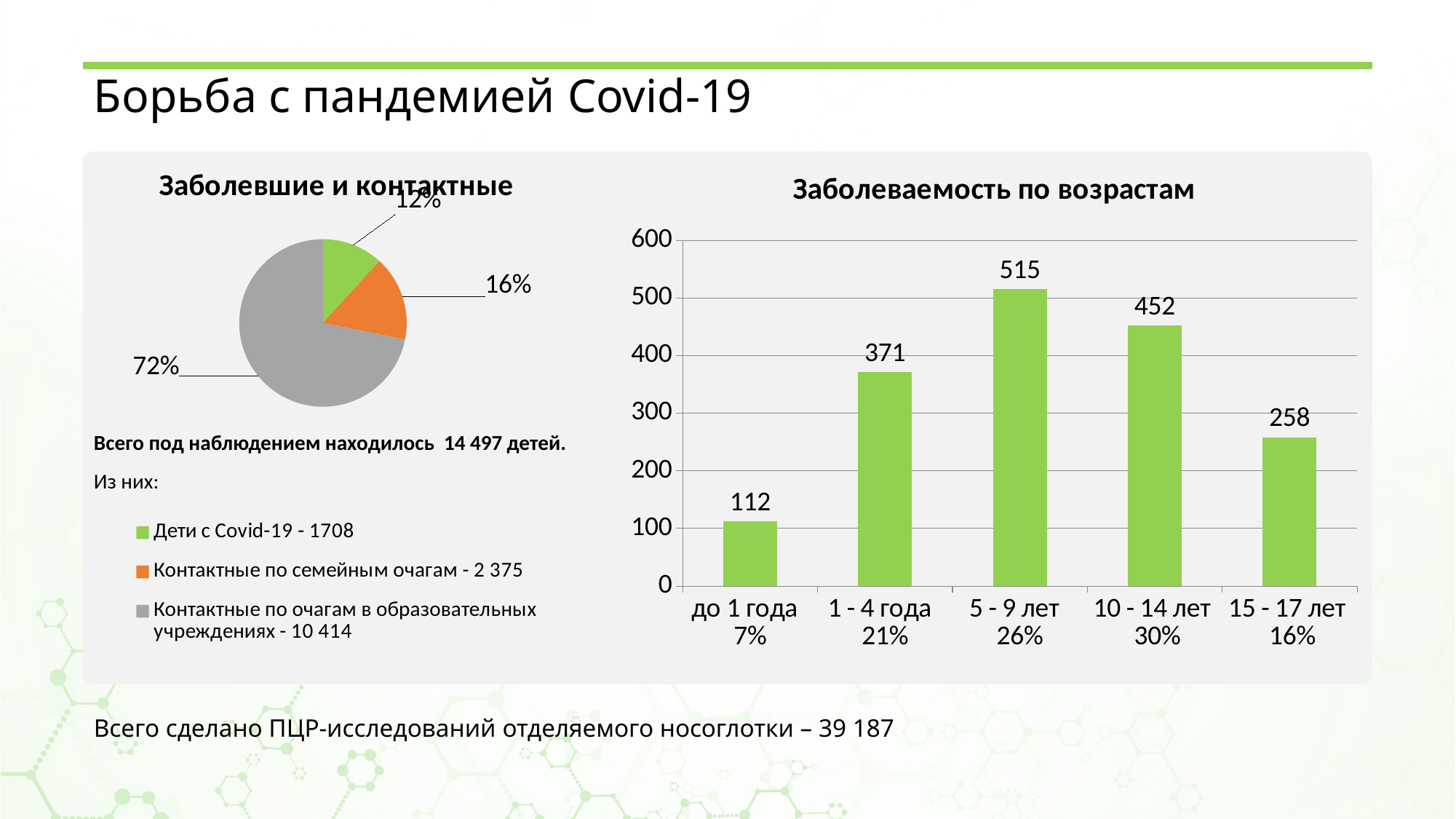
In the chart 'Заболеваемость по возрастам', what is the difference between the values for '10 - 14 лет' and '15 - 17 лет'? 194 What kind of chart is 'Заболевшие и контактные'? pie chart In the chart 'Заболеваемость по возрастам', what is the value for the '5 - 9 лет' age group? 515 How many age groups are shown in the chart 'Заболеваемость по возрастам'? 5 In the chart 'Заболеваемость по возрастам', what is the value for the 'до 1 года' age group? 112 In the pie chart 'Заболевшие и контактные', what colour is the slice for 'Контактные по семейным очагам'? orange What kind of chart is 'Заболеваемость по возрастам'? bar chart In the chart 'Заболеваемость по возрастам', which age group has the highest value? 5 - 9 лет In the pie chart 'Заболевшие и контактные', what share does the grey slice (Контактные по очагам в образовательных учреждениях) have? 72% In the chart 'Заболеваемость по возрастам', which age group has the lowest value? до 1 года In the chart 'Заболеваемость по возрастам', which is larger: the value for '1 - 4 года' or the value for '15 - 17 лет'? 1 - 4 года In the pie chart 'Заболевшие и контактные', what share does the slice for 'Дети с Covid-19' have? 12%